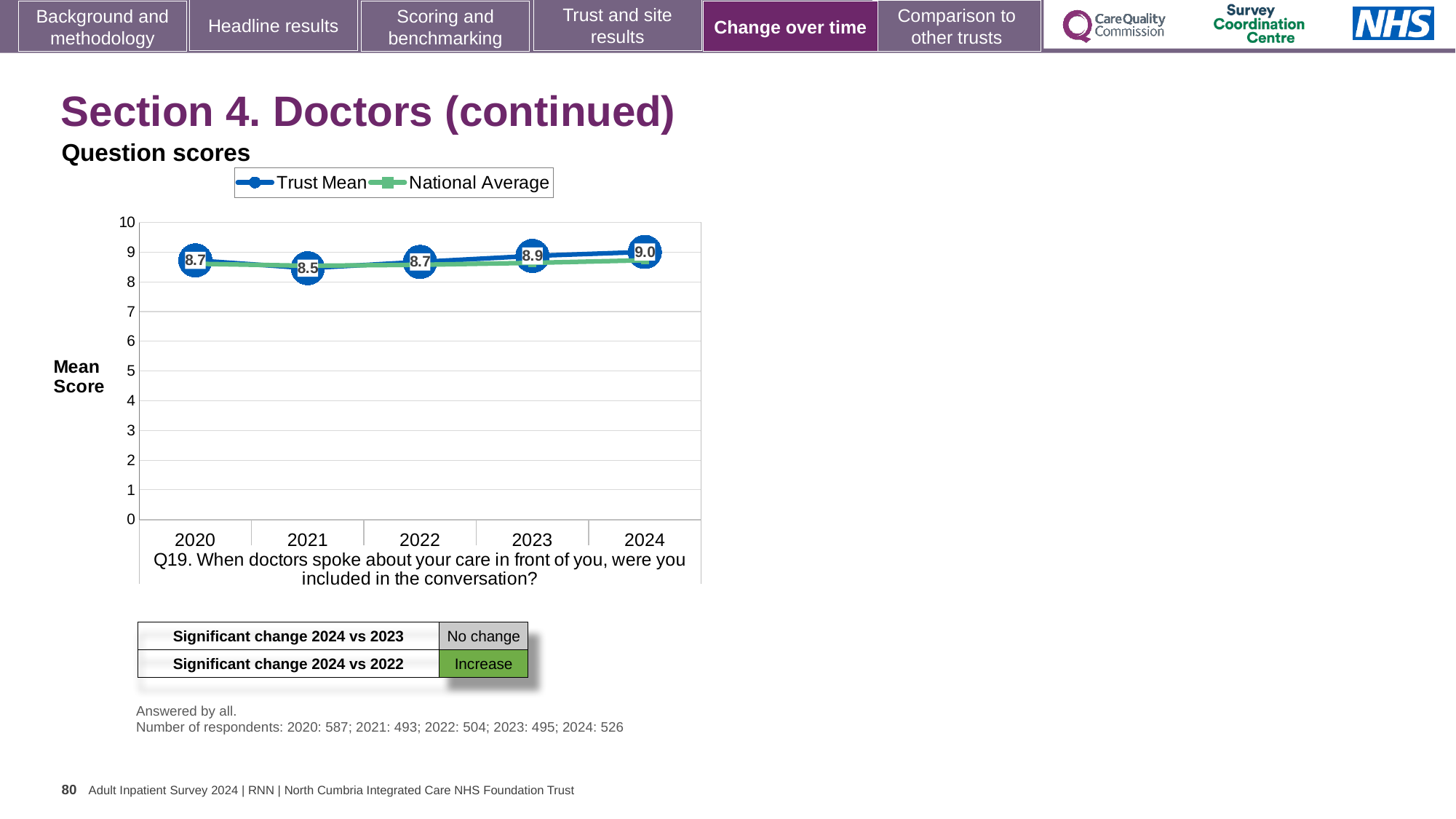
Is the National Average value for 2022 greater or less than 8? greater Which is larger, the Trust Mean for 2020 or for 2023? 2023 In which year is the Trust Mean highest? 2024 How many years are plotted on the x axis? 5 Does the Trust Mean rise or fall from 2021 to 2024? Rise What is the Trust Mean score for 2024? 9.0 How many series does the legend list? 2 What kind of chart is shown? Line chart What is the Trust Mean score for 2023? 8.9 In which year is the Trust Mean lowest? 2021 What is the difference between the Trust Mean in 2024 and in 2021? 0.5 What is the Trust Mean score for 2021? 8.5